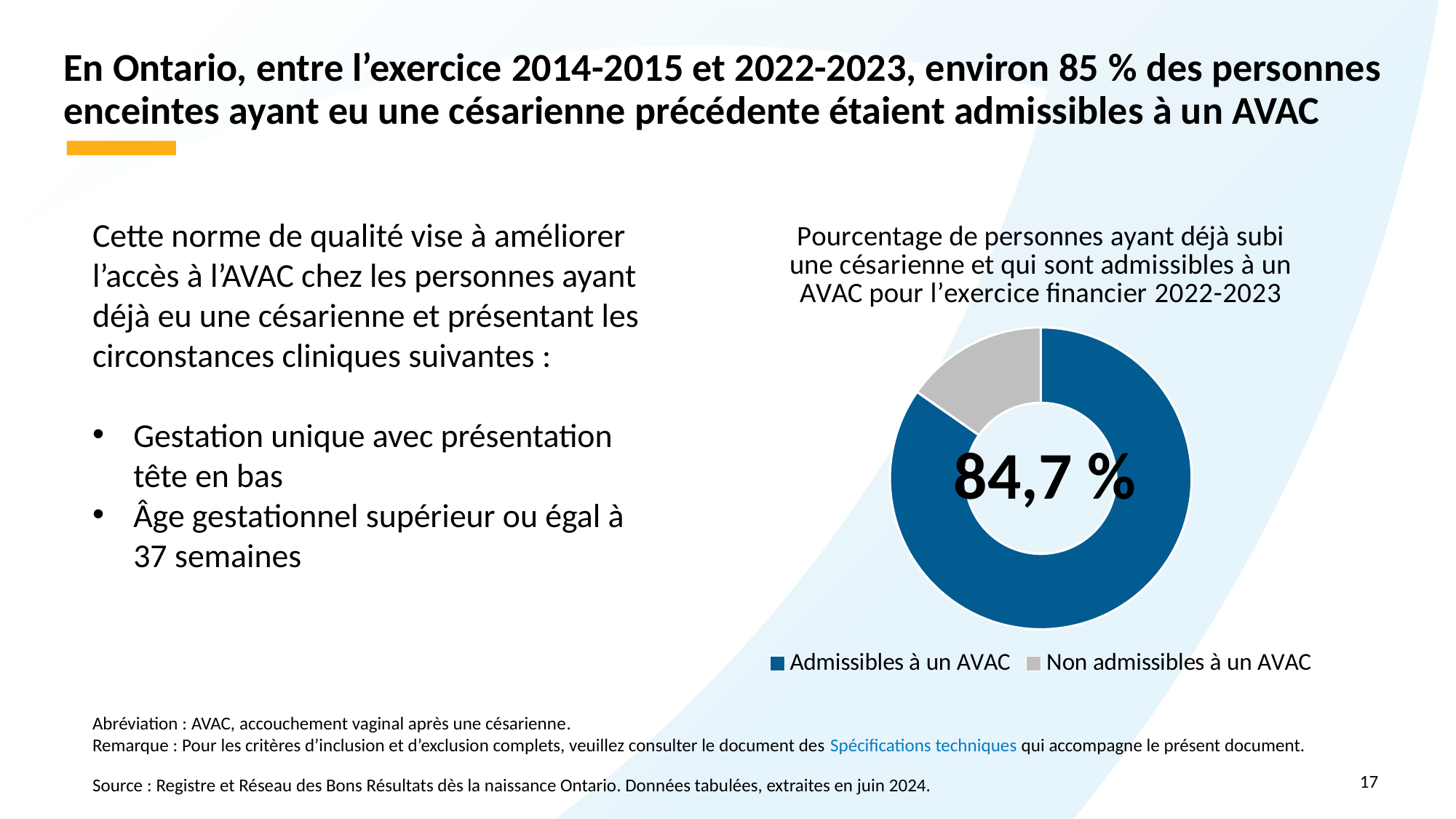
Which category is the largest slice of the donut chart? Admissibles à un AVAC What percentage is shown in the centre of the donut chart? 84,7 % What is the value for "Admissibles à un AVAC" in the donut chart? 84,7 % Which slice is larger, "Admissibles à un AVAC" or "Non admissibles à un AVAC"? Admissibles à un AVAC What is the title of the donut chart? Pourcentage de personnes ayant déjà subi une césarienne et qui sont admissibles à un AVAC pour l’exercice financier 2022-2023 Which fiscal year does the donut chart cover? 2022-2023 What colour represents "Non admissibles à un AVAC" in the donut chart? Grey How many categories does the legend of the donut chart list? 2 Which category is the smallest slice of the donut chart? Non admissibles à un AVAC What kind of chart is shown on the slide? Donut (pie) chart